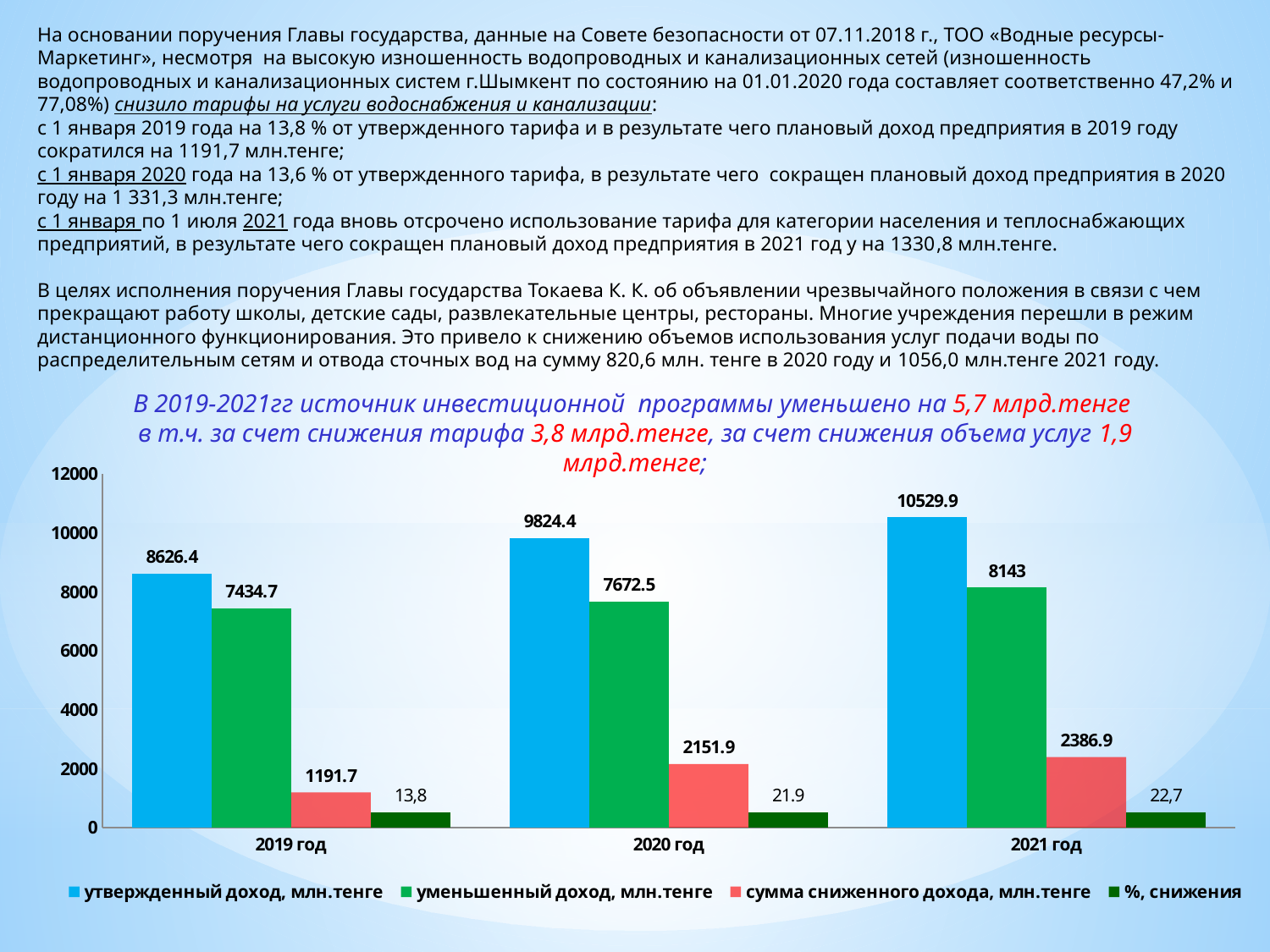
What is the value of «уменьшенный доход, млн.тенге» for 2021 год? 8143 In which year is «сумма сниженного дохода, млн.тенге» the lowest? 2019 год Does «утвержденный доход, млн.тенге» rise or fall from 2019 год to 2021 год? Rises How many year categories are shown on the x axis? 3 What type of chart is shown on the slide? Bar chart Which is larger: «уменьшенный доход» for 2019 год or for 2020 год? 2020 год What is the «%, снижения» value shown for 2021 год? 22,7 What is the value of «утвержденный доход, млн.тенге» for 2019 год? 8626.4 How many series does the legend list? 4 In which year is «утвержденный доход, млн.тенге» the highest? 2021 год What is the difference between «утвержденный доход» and «уменьшенный доход» for 2020 год? 2151.9 What is the value of «сумма сниженного дохода, млн.тенге» for 2020 год? 2151.9